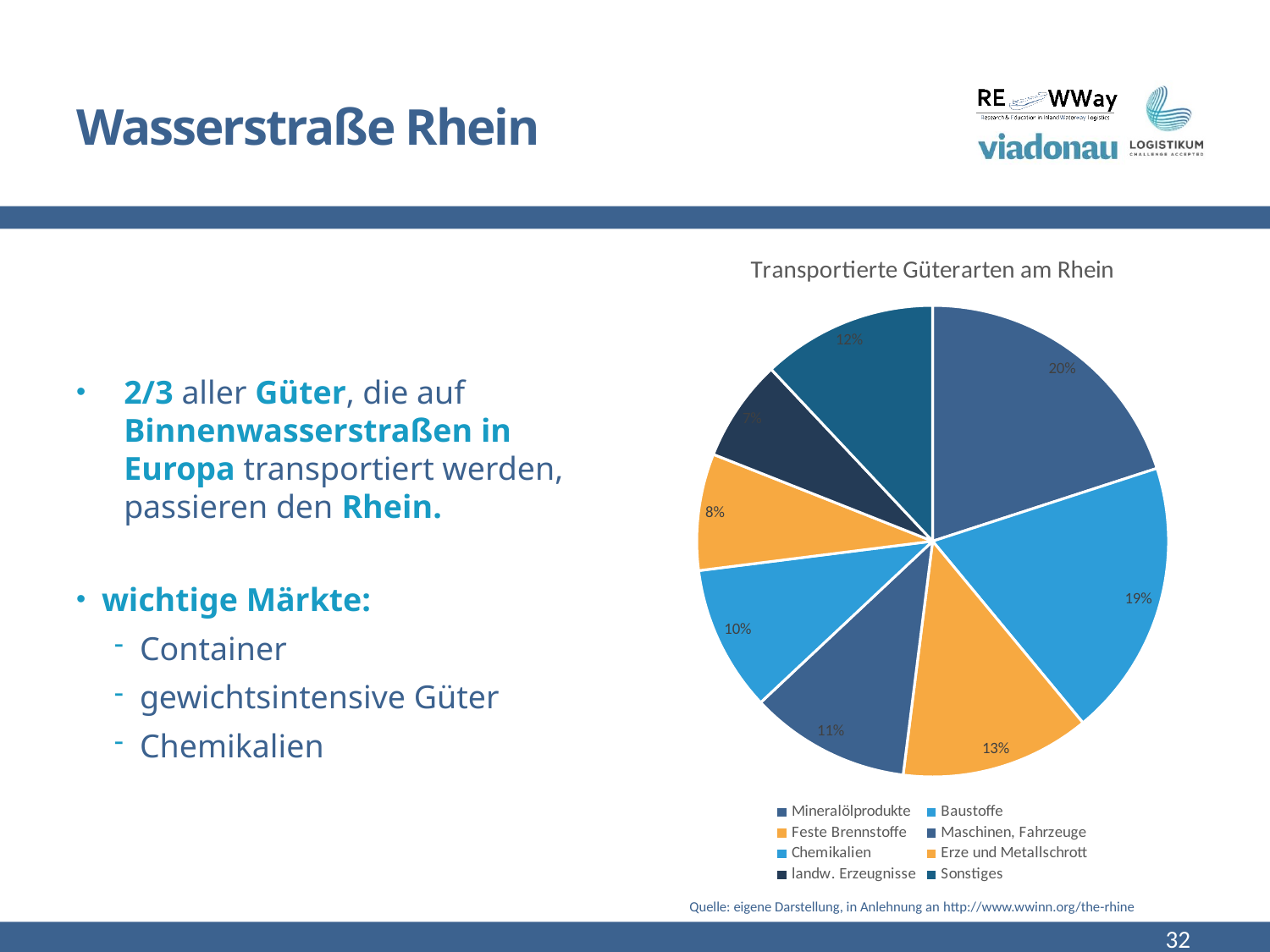
Which is larger, the share of Maschinen, Fahrzeuge or the share of Sonstiges? Sonstiges How many entries does the legend list? 8 Which category has the smallest share of the pie? landw. Erzeugnisse What is the value for Chemikalien? 10% What share of the pie is Baustoffe? 19% What kind of chart is shown on the slide? pie chart What is the title of the chart? Transportierte Güterarten am Rhein What share of the pie is Mineralölprodukte? 20% What is the difference between the shares of Sonstiges and Erze und Metallschrott? 4% Which category has the largest share of the pie? Mineralölprodukte What is the value for Feste Brennstoffe? 13% How many slices does the pie chart have? 8